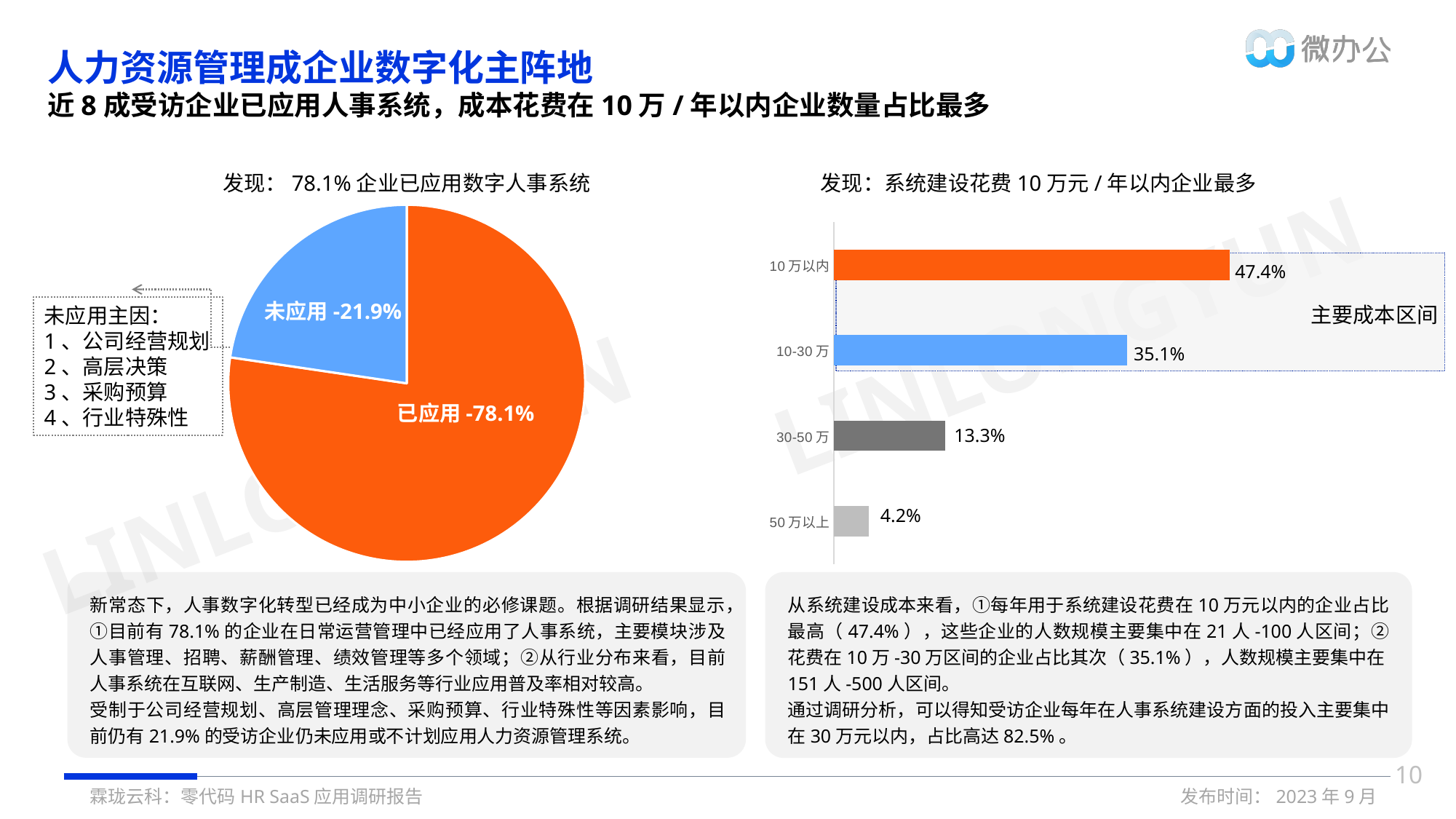
In the bar chart on the right, how many cost ranges are shown? 4 In the pie chart on the left, what share of enterprises have already applied a digital HR system (已应用)? 78.1% In the bar chart on the right, what is the value for 10 万以内? 47.4% In the bar chart on the right, which cost range has the lowest share? 50 万以上 What kind of chart is the chart on the left of the slide? Pie chart What kind of chart is the chart on the right of the slide? Bar chart In the bar chart on the right, what is the difference between the values for 10 万以内 and 10-30 万? 12.3% In the pie chart on the left, which slice is larger, 已应用 or 未应用? 已应用 In the pie chart on the left, how many slices are there? 2 In the bar chart on the right, what is the value for 30-50 万? 13.3% In the bar chart on the right, which cost range has the highest share? 10 万以内 In the pie chart on the left, what share of enterprises have not applied a digital HR system (未应用)? 21.9%